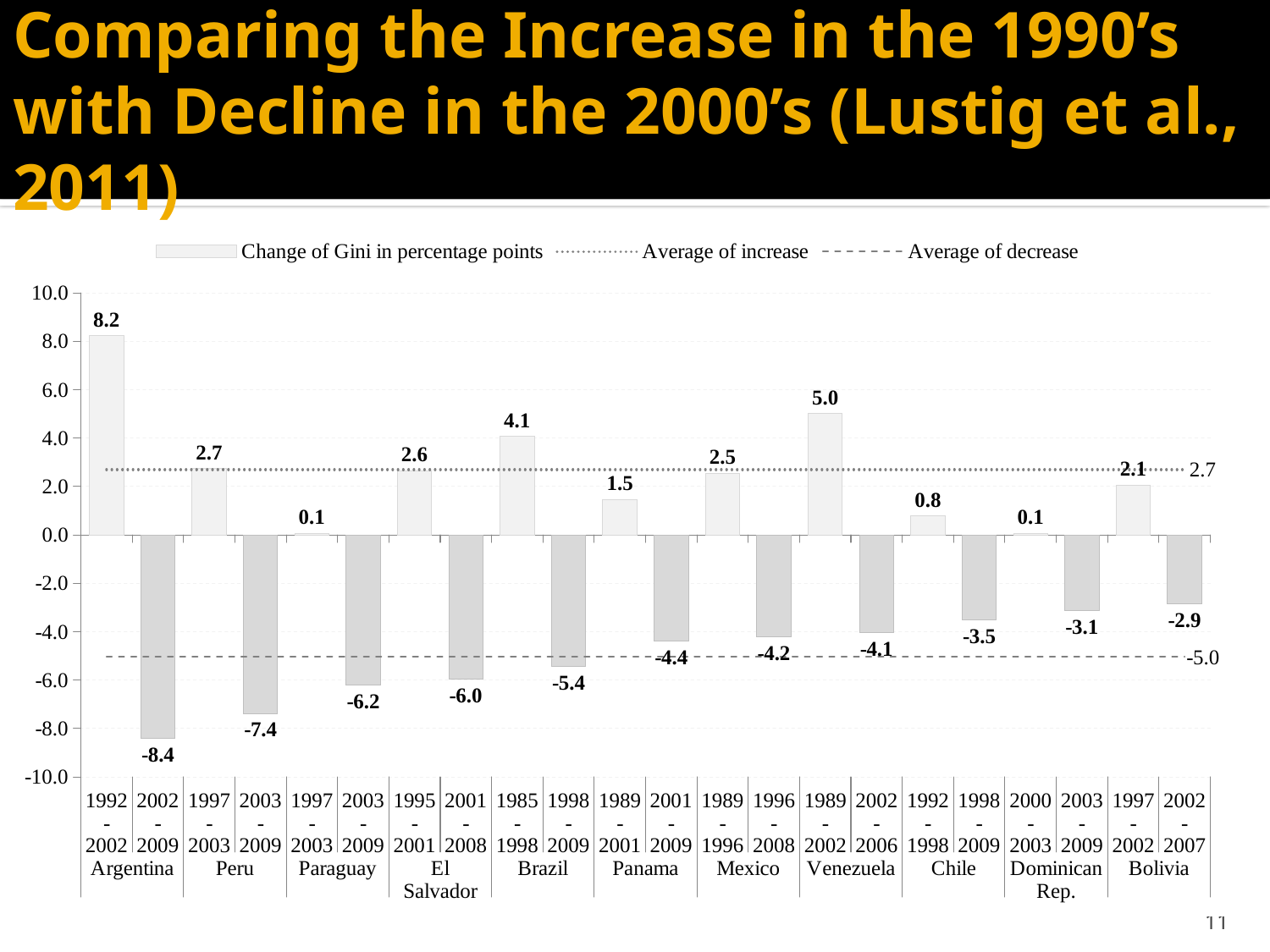
What is the change of Gini in percentage points for Argentina in 1992-2002? 8.2 Which is larger, the change of Gini for Brazil in 1985-1998 or for Mexico in 1989-1996? Brazil 1985-1998 What is the change of Gini in percentage points for Brazil in 1998-2009? -5.4 What kind of chart is shown on the slide? Combination bar and line chart (bars with two average lines) Which country-period has the highest change of Gini in percentage points? Argentina 1992-2002 How many countries are shown on the x axis of the chart? 11 What value does the 'Average of increase' line mark? 2.7 What value does the 'Average of decrease' line mark? -5.0 Which country-period has the lowest change of Gini in percentage points? Argentina 2002-2009 What is the change of Gini in percentage points for Venezuela in 1989-2002? 5.0 What is the difference between the change of Gini for Peru in 1997-2003 and Peru in 2003-2009? 10.1 How many entries does the legend list? 3